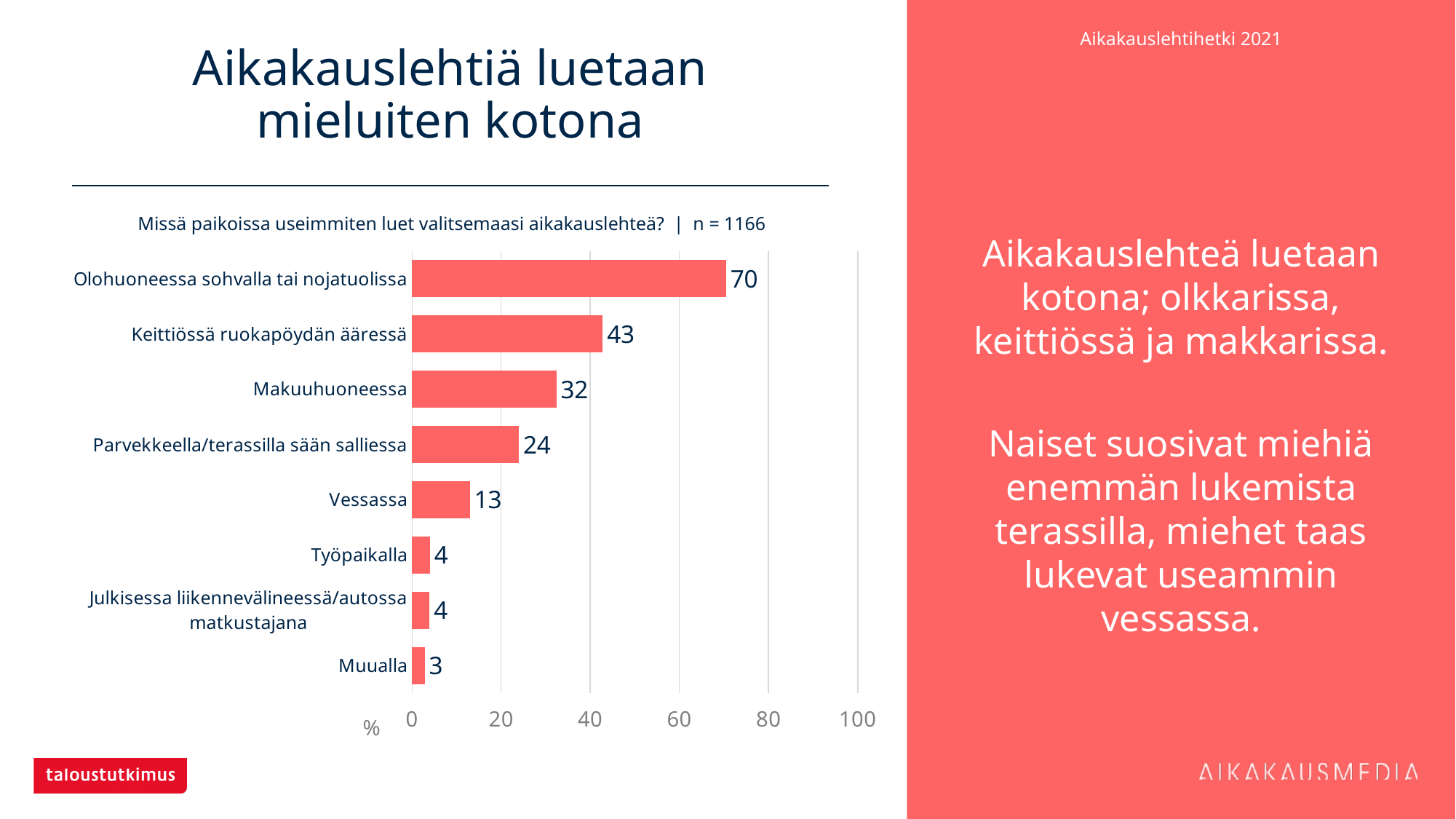
Which category has the highest value? Olohuoneessa sohvalla tai nojatuolissa How many categories are shown in the chart? 8 Is the value for Keittiössä ruokapöydän ääressä greater or less than 40? greater What is the value for Vessassa? 13 What is the value for Työpaikalla? 4 What is the value for Makuuhuoneessa? 32 What is the sample size (n) stated above the chart? 1166 What is the value for Olohuoneessa sohvalla tai nojatuolissa? 70 Which is larger, the value for Parvekkeella/terassilla sään salliessa or the value for Vessassa? Parvekkeella/terassilla sään salliessa What kind of chart is shown on the slide? Bar chart What is the difference between the values for Keittiössä ruokapöydän ääressä and Makuuhuoneessa? 11 Which category has the lowest value? Muualla